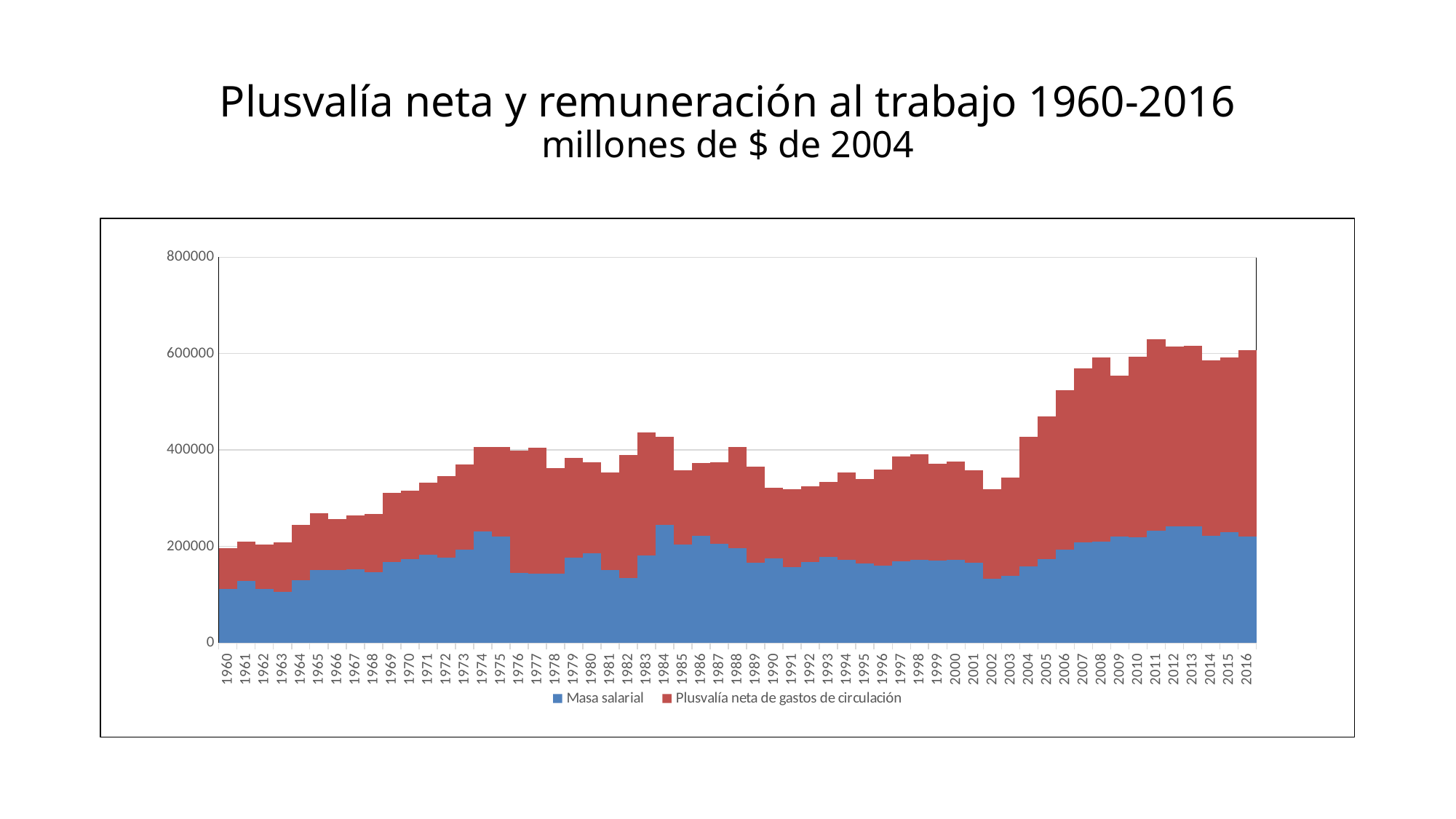
Is the combined total for 1990 greater or less than 400000? less Which series is shown in blue? Masa salarial What kind of chart is shown on the slide? Stacked bar chart Is the value for Masa salarial in 1984 greater or less than 200000? greater Is the combined total for 2007 greater or less than 600000? less How many years are plotted along the x axis? 57 What are the two series named in the legend? Masa salarial; Plusvalía neta de gastos de circulación How many series does the legend list? 2 Overall, does the combined total rise or fall from 1960 to 2016? rise Which year has the lowest combined total, 1960 or 2016? 1960